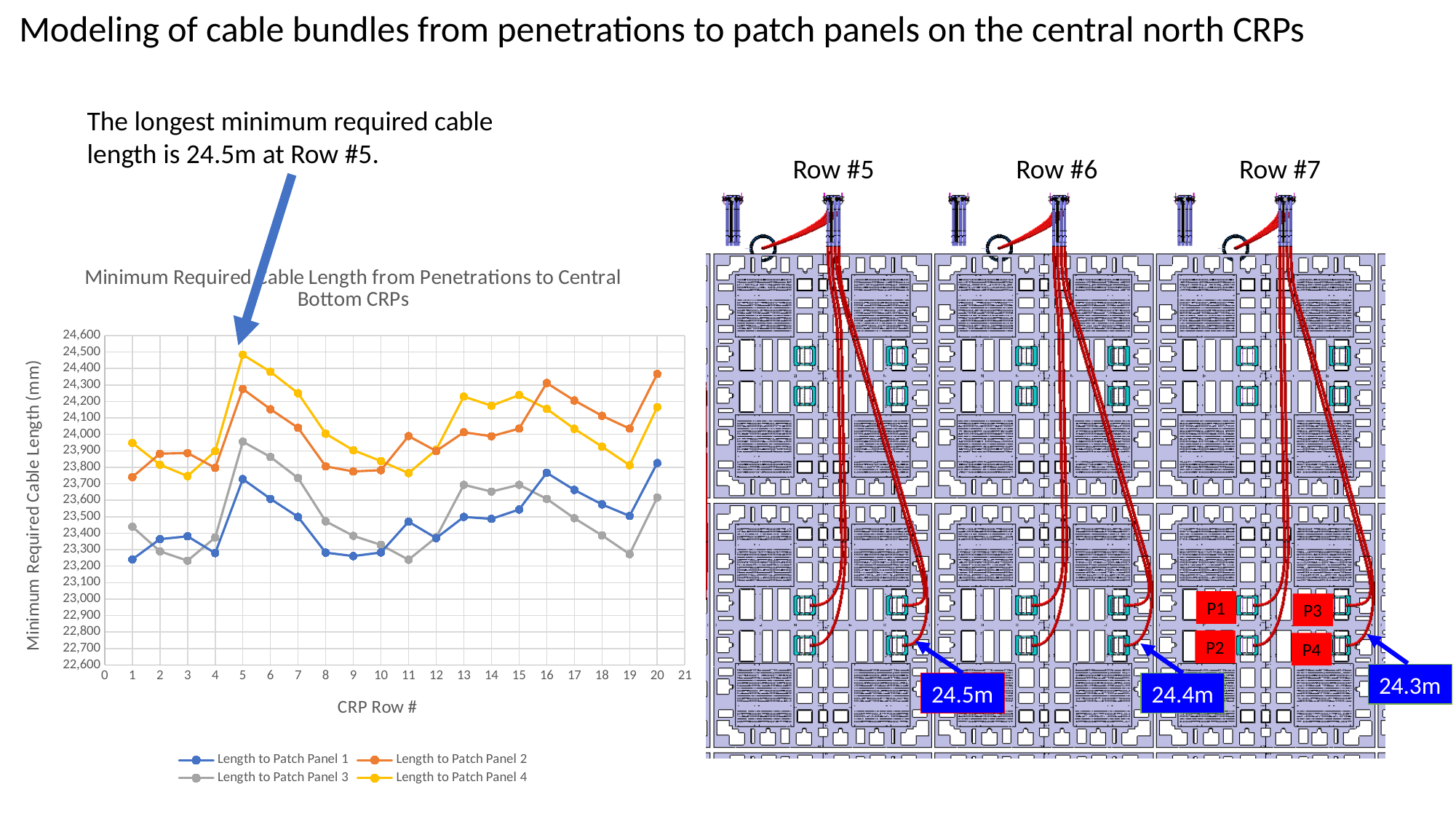
How many series does the chart legend list? 4 Does the Length to Patch Panel 1 series rise or fall from CRP row 5 to CRP row 8? Fall Is the value for Length to Patch Panel 2 at CRP row 20 greater or less than 24,300? greater Is the value for Length to Patch Panel 4 at CRP row 5 greater or less than 24,400? greater Which series has the highest value at CRP row 5? Length to Patch Panel 4 What kind of chart is shown on the slide? Line chart At CRP row 20, which is larger: Length to Patch Panel 2 or Length to Patch Panel 4? Length to Patch Panel 2 At which CRP row does the Length to Patch Panel 4 series reach its highest value? Row 5 Is the value for Length to Patch Panel 1 at CRP row 1 greater or less than 23,300? less How many CRP rows are plotted for each series in the chart? 20 What is the title of the x axis of the chart? CRP Row # Which series has the lowest value at CRP row 5? Length to Patch Panel 1